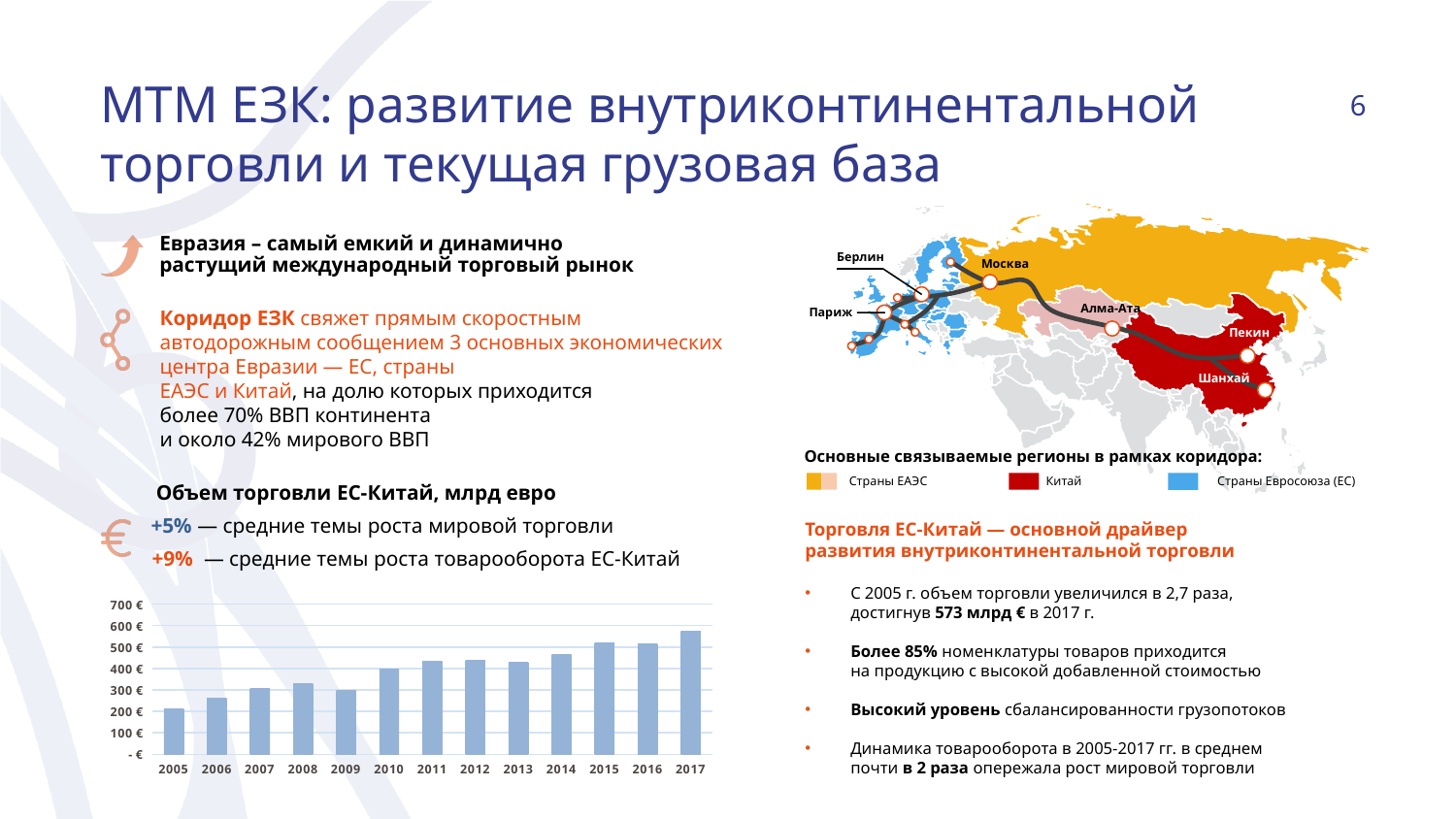
Which year has the larger value, 2014 or 2013? 2014 Which year has the lowest bar on the chart? 2005 Is the value for 2005 greater or less than 300 €? less What is the highest tick label shown on the vertical axis of the bar chart? 700 € Is the value for 2008 greater or less than 300 €? greater Is the value for 2017 greater or less than 500 €? greater What kind of chart is shown under the heading "Объем торговли ЕС-Китай, млрд евро"? bar chart Which year has the larger value, 2008 or 2009? 2008 How many years are plotted on the bar chart? 13 Which year has the highest bar on the chart? 2017 Do the values on the bar chart generally rise or fall from 2005 to 2017? rise